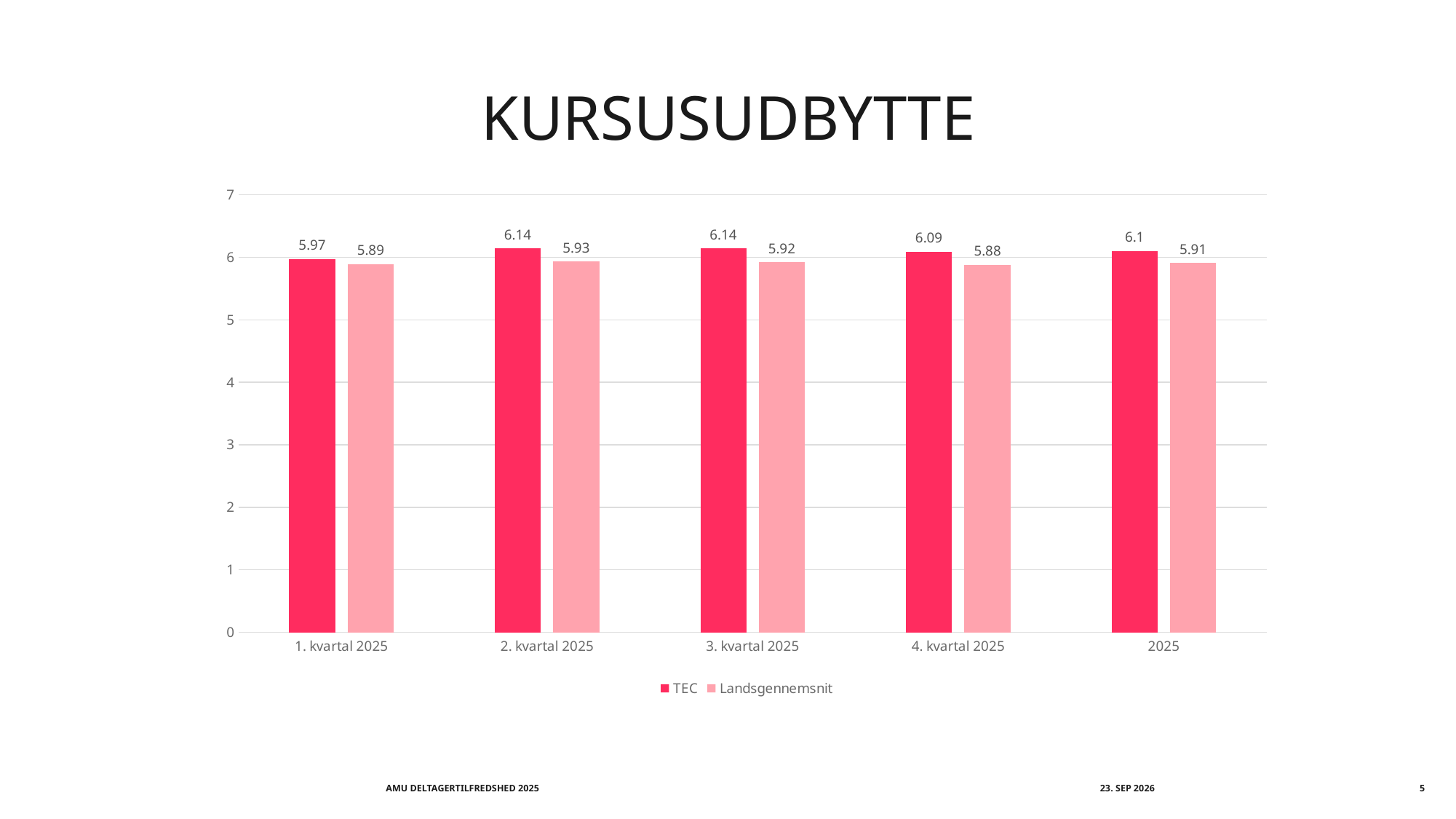
What is the Landsgennemsnit value for 4. kvartal 2025? 5.88 What is the Landsgennemsnit value for 2. kvartal 2025? 5.93 What is the TEC value for 1. kvartal 2025? 5.97 What is the TEC value for 2025? 6.1 What is the title of the chart? KURSUSUDBYTTE How many series does the legend list? 2 Which category has the lowest TEC value? 1. kvartal 2025 Which category has the highest Landsgennemsnit value? 2. kvartal 2025 Which is larger for 4. kvartal 2025, TEC or Landsgennemsnit? TEC What is the difference between the TEC and Landsgennemsnit values for 3. kvartal 2025? 0.22 How many categories are shown on the x axis? 5 What kind of chart is shown on the slide? Bar chart